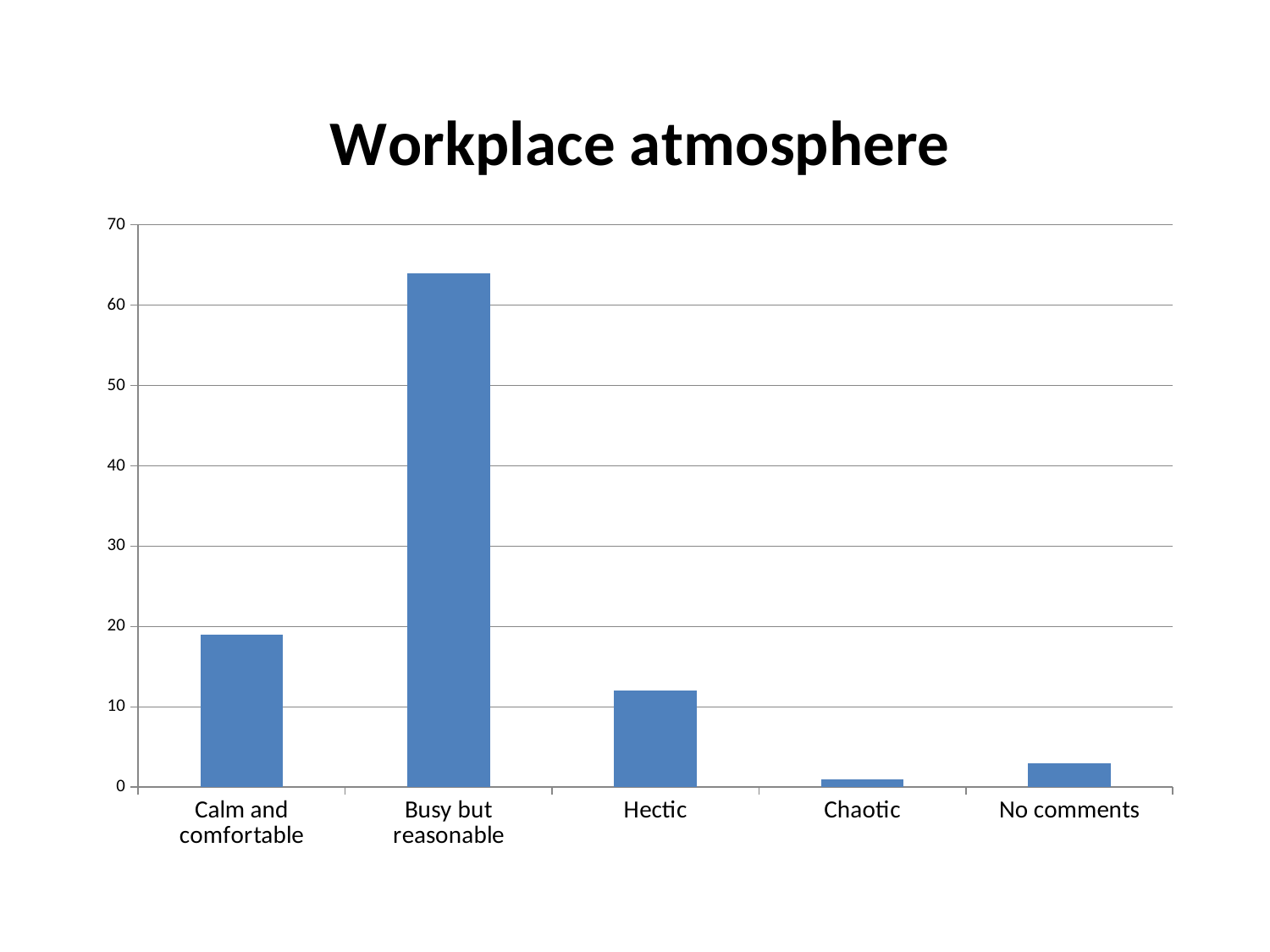
What kind of chart is shown on the slide? bar chart Is the value for Busy but reasonable greater or less than 60? greater Which is larger, the value for Calm and comfortable or the value for Hectic? Calm and comfortable How many categories are shown on the x axis? 5 What is the title of the chart? Workplace atmosphere Which category has the lowest value? Chaotic Is the value for Hectic greater or less than 20? less Is the value for No comments greater or less than 10? less Which is larger, the value for Chaotic or the value for No comments? No comments Which category has the highest value? Busy but reasonable